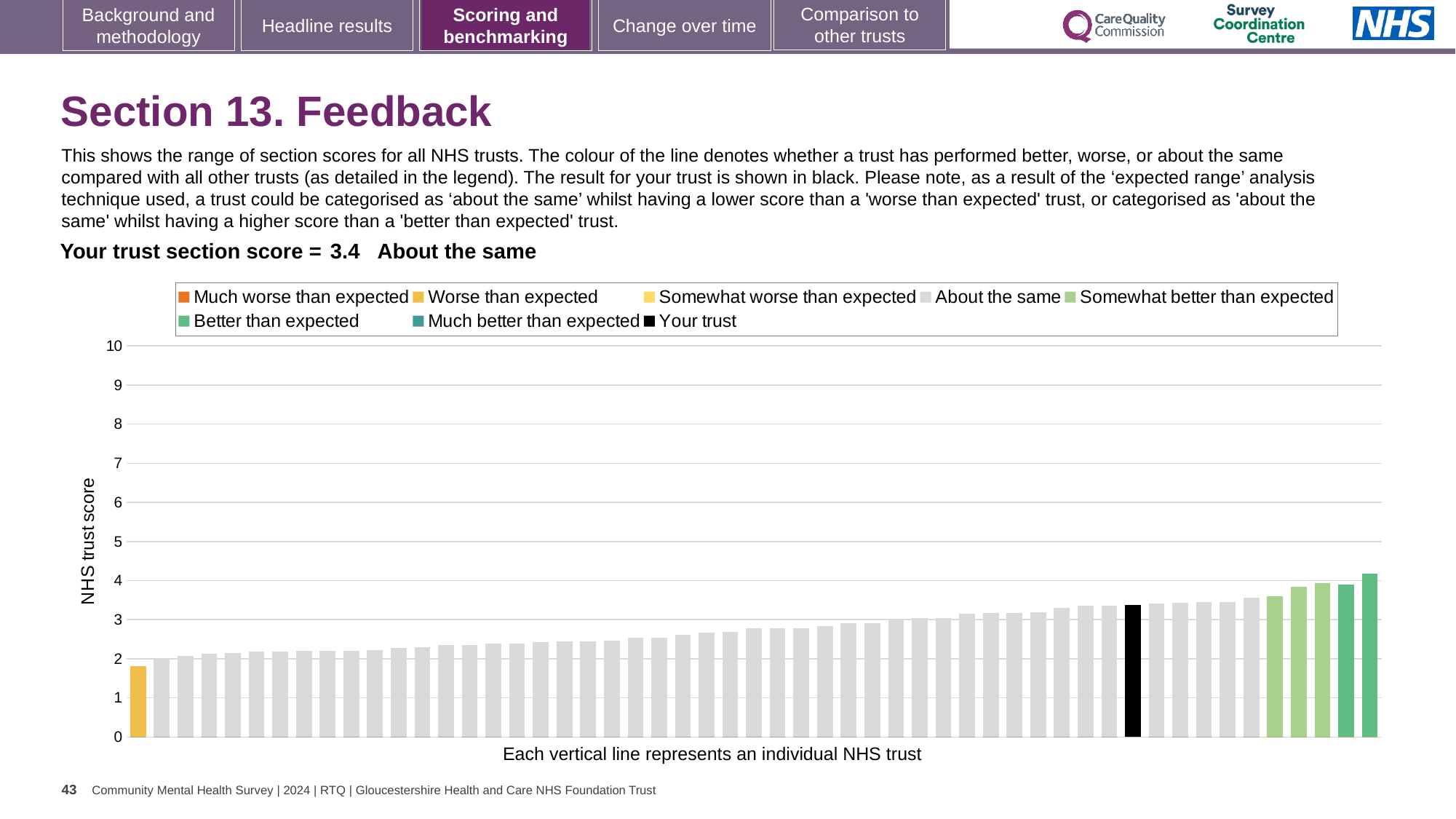
Which performance category is your trust placed in for this section? About the same Do the bar values rise or fall from left to right along the x axis? rise What is the label on the y axis of the chart? NHS trust score Is the value for your trust (the black bar) greater or less than 4? less How many bars are coloured yellow (worse than expected)? 1 How many entries does the chart legend list? 8 What kind of chart is shown on the slide? bar chart What is the section score for your trust shown on the slide? 3.4 What colour is used for the bar representing your trust? black Is the value of the highest bar (rightmost) greater or less than 4? greater Is the value for your trust (the black bar) greater or less than 3? greater